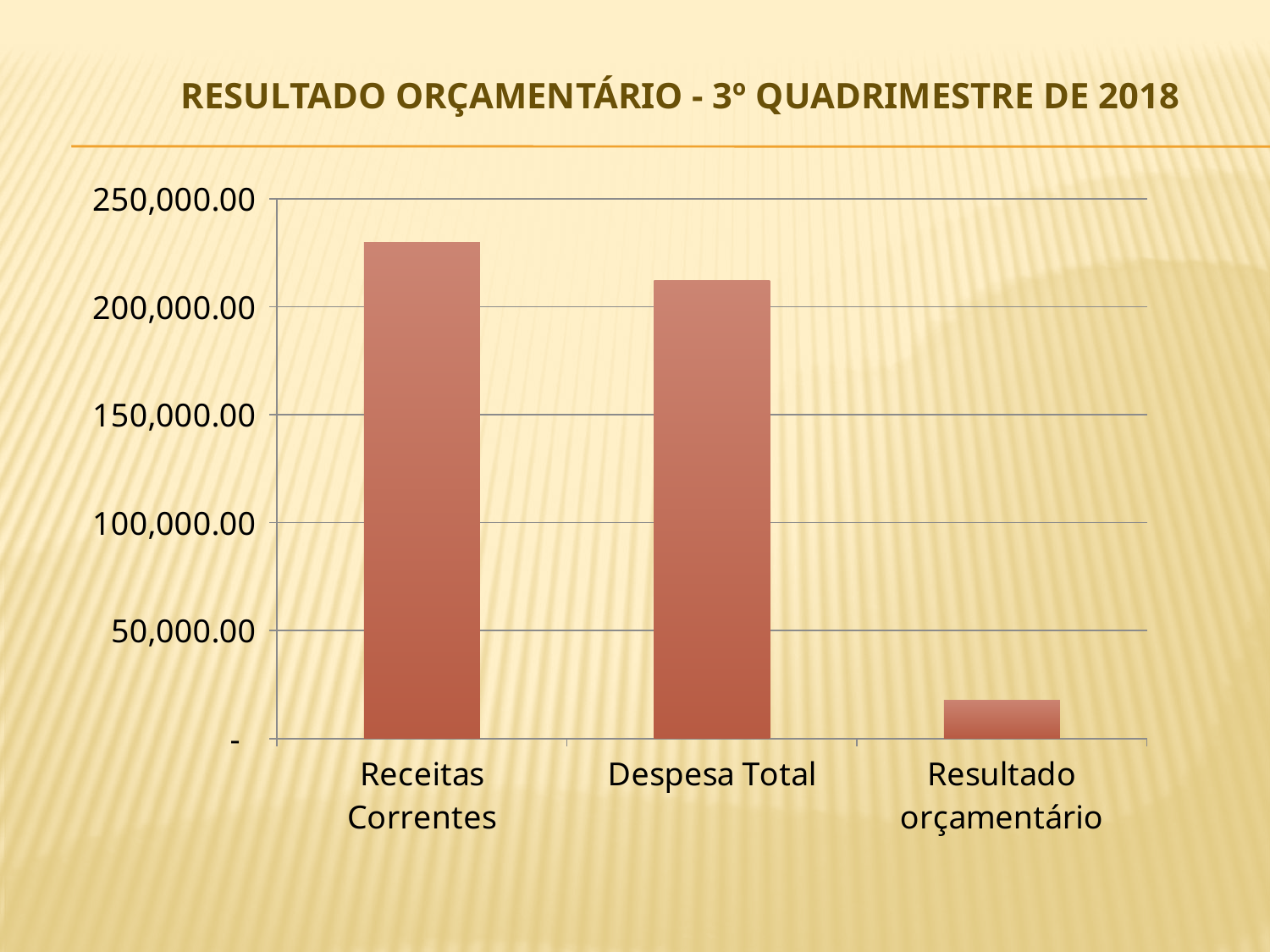
Is the value for Receitas Correntes greater or less than 200,000.00? greater How many categories are plotted on the chart? 3 What kind of chart is shown on the slide? bar chart Which category has the highest value? Receitas Correntes Is the value for Resultado orçamentário greater or less than 50,000.00? less Do the values rise or fall from left to right along the x axis? fall What is the highest value shown on the vertical axis? 250,000.00 Which is larger, the value for Receitas Correntes or the value for Despesa Total? Receitas Correntes Which category has the lowest value? Resultado orçamentário Which is larger, the value for Despesa Total or the value for Resultado orçamentário? Despesa Total Is the value for Despesa Total greater or less than 250,000.00? less What is the title of the chart? RESULTADO ORÇAMENTÁRIO - 3º QUADRIMESTRE DE 2018